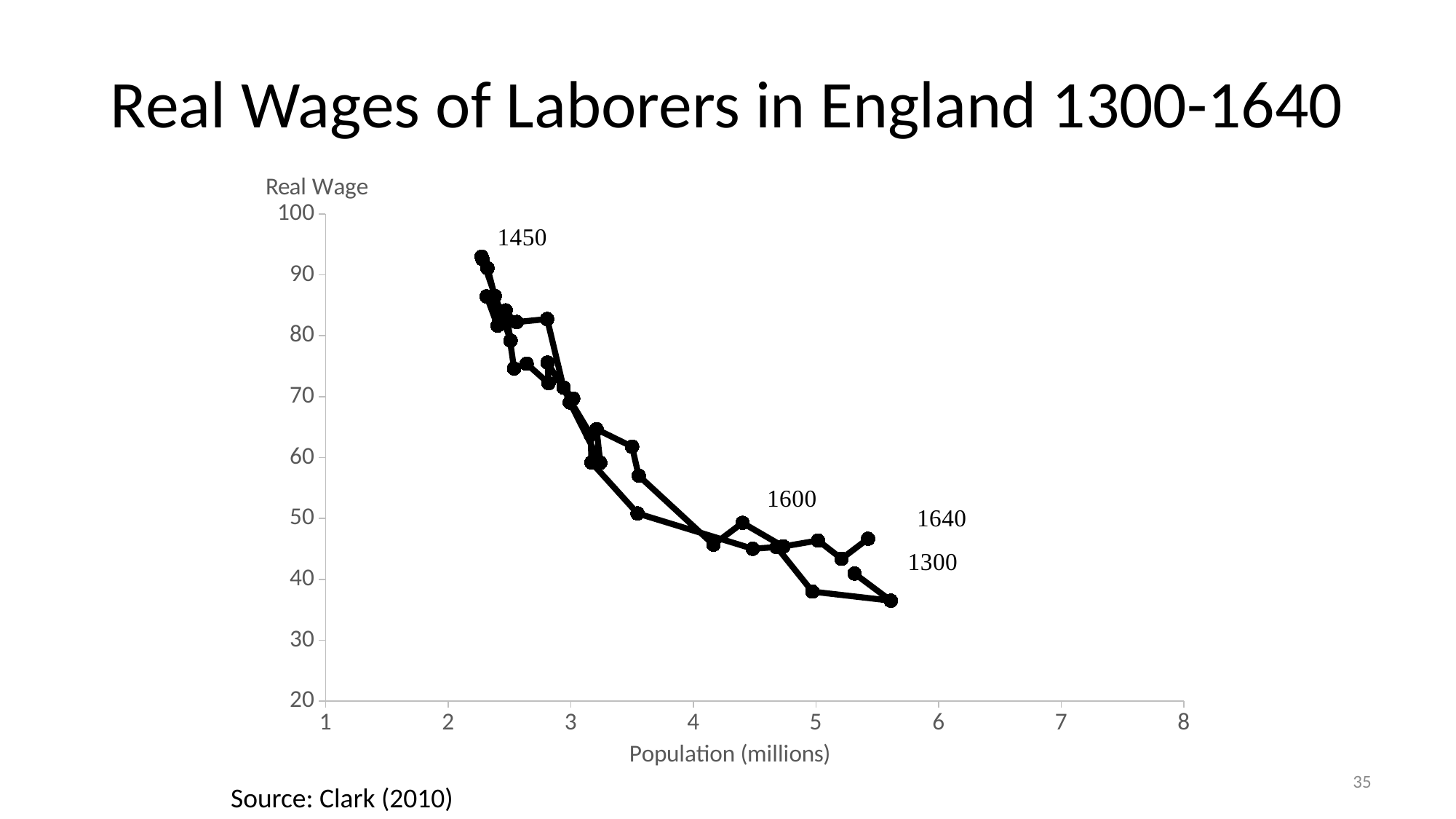
Is the real wage at the point labeled 1300 greater or less than 40? less What kind of chart is shown on the slide? Scatter chart with connected points What is the title of the chart? Real Wages of Laborers in England 1300-1640 Is the population at the point labeled 1300 greater or less than 5 million? greater Is the population at the point labeled 1450 greater or less than 3 million? less As population increases along the x axis, does the real wage generally rise or fall? fall Which point has the higher real wage, the one labeled 1450 or the one labeled 1300? 1450 What is the label of the horizontal axis? Population (millions) How many year labels are printed next to points on the chart? 4